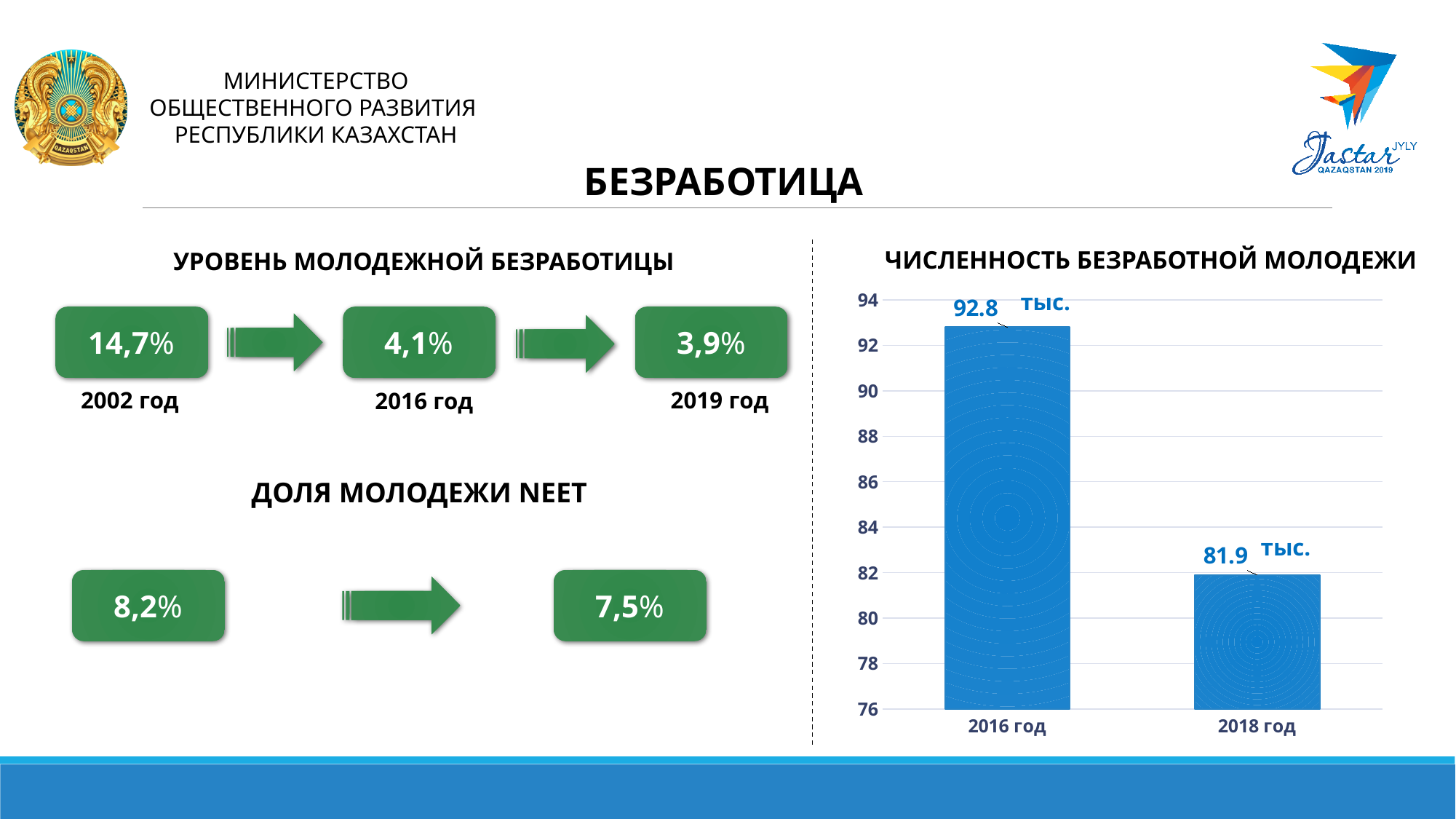
In the chart "ЧИСЛЕННОСТЬ БЕЗРАБОТНОЙ МОЛОДЕЖИ", which is larger: the value for 2016 год or for 2018 год? 2016 год What type of chart is "ЧИСЛЕННОСТЬ БЕЗРАБОТНОЙ МОЛОДЕЖИ"? Bar chart In the chart "ЧИСЛЕННОСТЬ БЕЗРАБОТНОЙ МОЛОДЕЖИ", which year has the lowest value? 2018 год In the chart "ЧИСЛЕННОСТЬ БЕЗРАБОТНОЙ МОЛОДЕЖИ", what is the value for 2016 год? 92.8 тыс. In the chart "ЧИСЛЕННОСТЬ БЕЗРАБОТНОЙ МОЛОДЕЖИ", what is the value for 2018 год? 81.9 тыс. In the chart "ЧИСЛЕННОСТЬ БЕЗРАБОТНОЙ МОЛОДЕЖИ", do the values rise or fall from 2016 год to 2018 год? Fall How many bars are shown in the chart "ЧИСЛЕННОСТЬ БЕЗРАБОТНОЙ МОЛОДЕЖИ"? 2 What is the lowest value shown on the vertical axis of the chart "ЧИСЛЕННОСТЬ БЕЗРАБОТНОЙ МОЛОДЕЖИ"? 76 In the chart "ЧИСЛЕННОСТЬ БЕЗРАБОТНОЙ МОЛОДЕЖИ", is the value for 2018 год greater or less than 84? less In the chart "ЧИСЛЕННОСТЬ БЕЗРАБОТНОЙ МОЛОДЕЖИ", what is the difference between the values for 2016 год and 2018 год? 10.9 тыс. In the chart "ЧИСЛЕННОСТЬ БЕЗРАБОТНОЙ МОЛОДЕЖИ", which year has the highest value? 2016 год In the chart "ЧИСЛЕННОСТЬ БЕЗРАБОТНОЙ МОЛОДЕЖИ", is the value for 2016 год greater or less than 90? greater